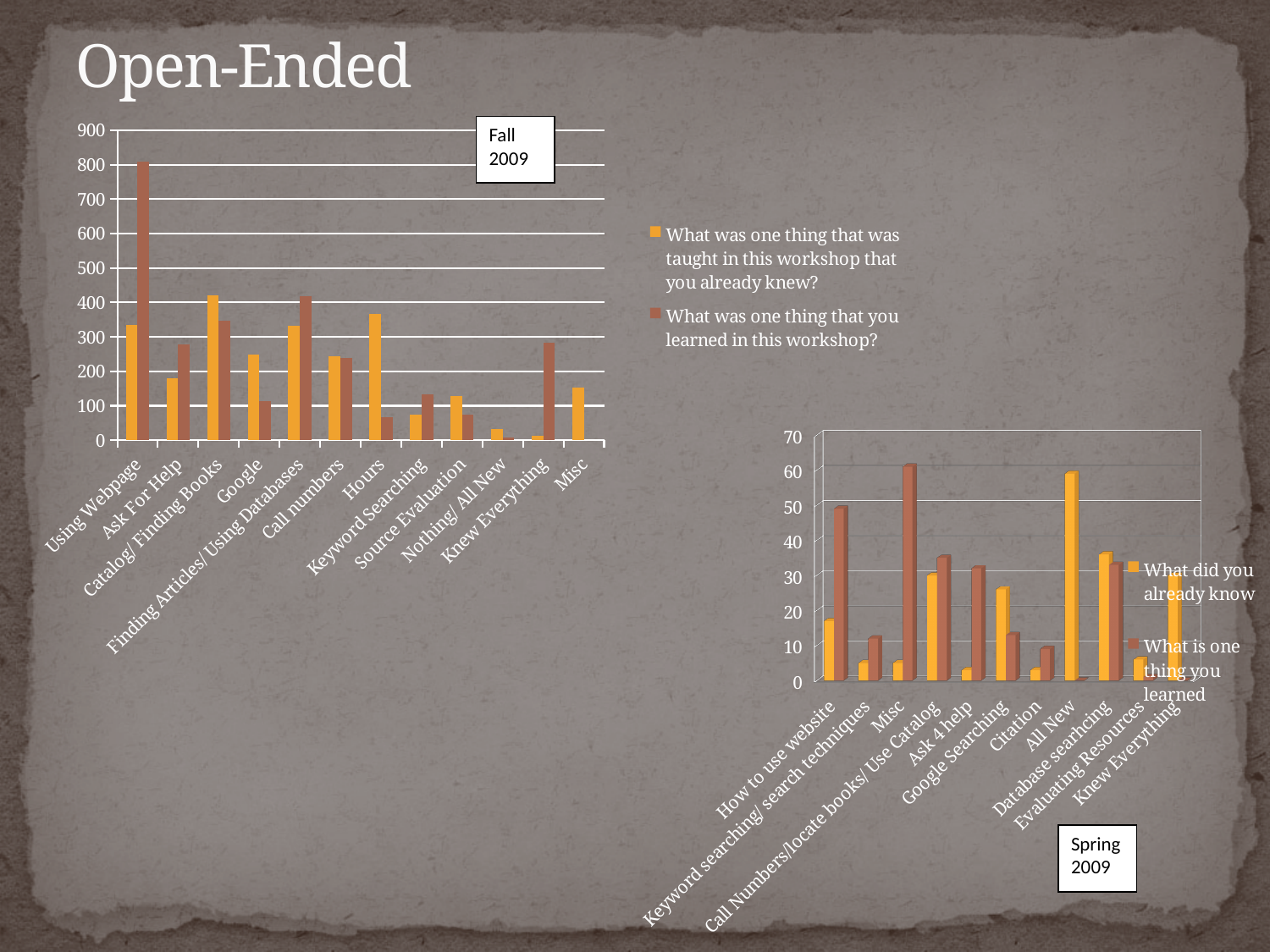
How many categories are shown on the x axis of the Spring 2009 chart? 11 How many series does the legend of the Fall 2009 chart list? 2 In the Spring 2009 chart, is the 'What is one thing you learned' value for How to use website greater or less than 40? greater In the Fall 2009 chart, which category has the highest value for the 'What was one thing that you learned in this workshop?' series? Using Webpage What kind of chart is the Spring 2009 chart? bar chart In the Fall 2009 chart, is the 'What was one thing that you learned in this workshop?' value for Using Webpage greater or less than 700? greater In the Fall 2009 chart, for Google, which series has the larger value: 'already knew' or 'learned'? already knew In the Spring 2009 chart, which category has the highest value for the 'What did you already know' series? All New How many categories are shown on the x axis of the Fall 2009 chart? 12 In the Fall 2009 chart, is the 'What was one thing that was taught in this workshop that you already knew?' value for Hours greater or less than 300? greater In the Fall 2009 chart, for Knew Everything, which series has the larger value: 'already knew' or 'learned'? learned In the Spring 2009 chart, which category has the highest value for the 'What is one thing you learned' series? Misc